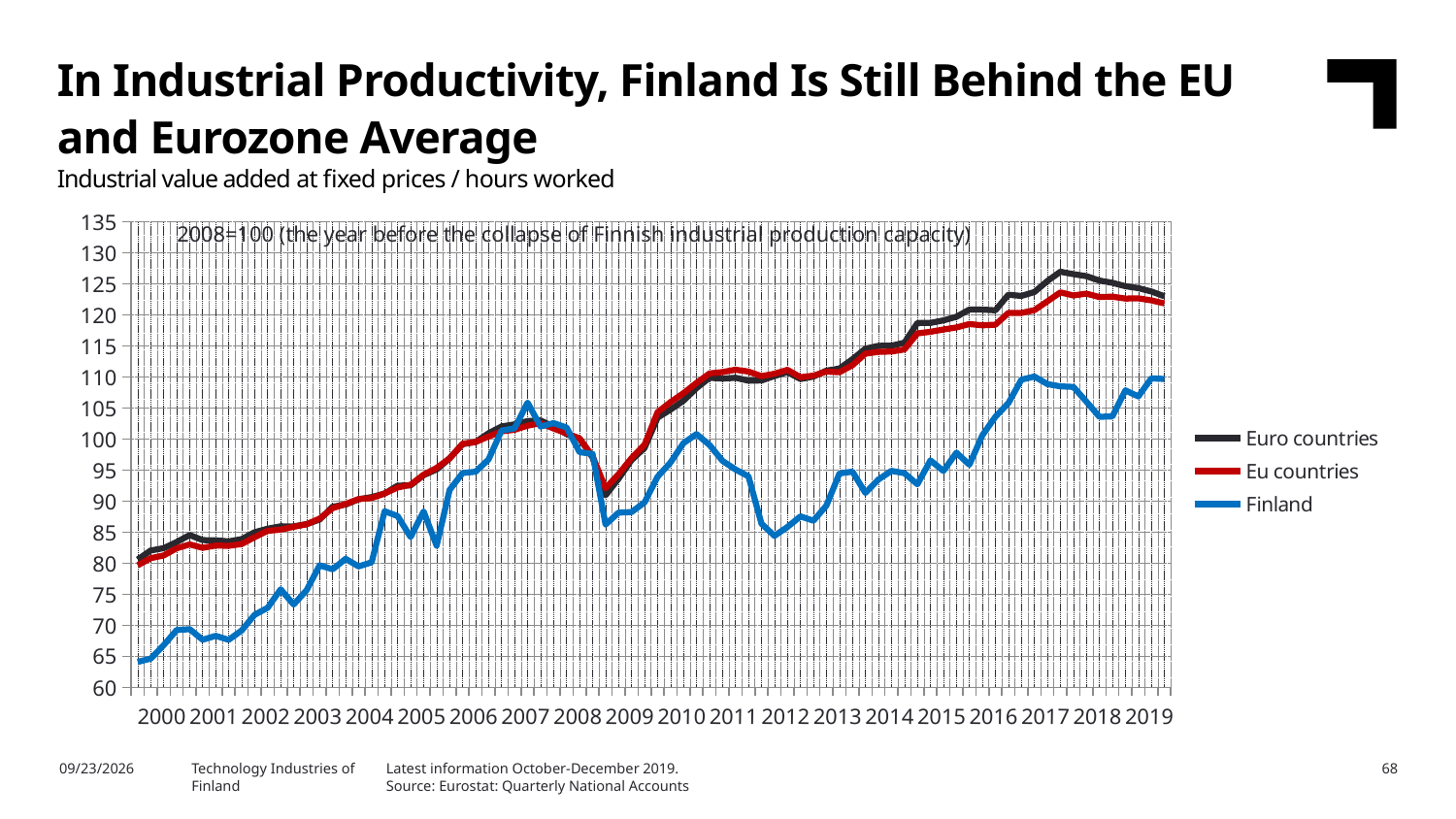
Is the lowest value for Finland in 2012 greater or less than 90? less How many years are labelled on the x axis? 20 Does the Finland series rise or fall between 2000 and 2007? Rise What base year is the index set to 100, according to the annotation on the chart? 2008 Is the value for Finland at the start of 2000 greater or less than 70? less Which series has the lowest value at the end of 2019? Finland How many series does the legend list? 3 At the end of 2019, which is larger: the value for Euro countries or the value for Finland? Euro countries Is the value for Euro countries at the end of 2019 greater or less than 120? greater What kind of chart is shown on the slide? Line chart Which series are listed in the legend? Euro countries, Eu countries, Finland